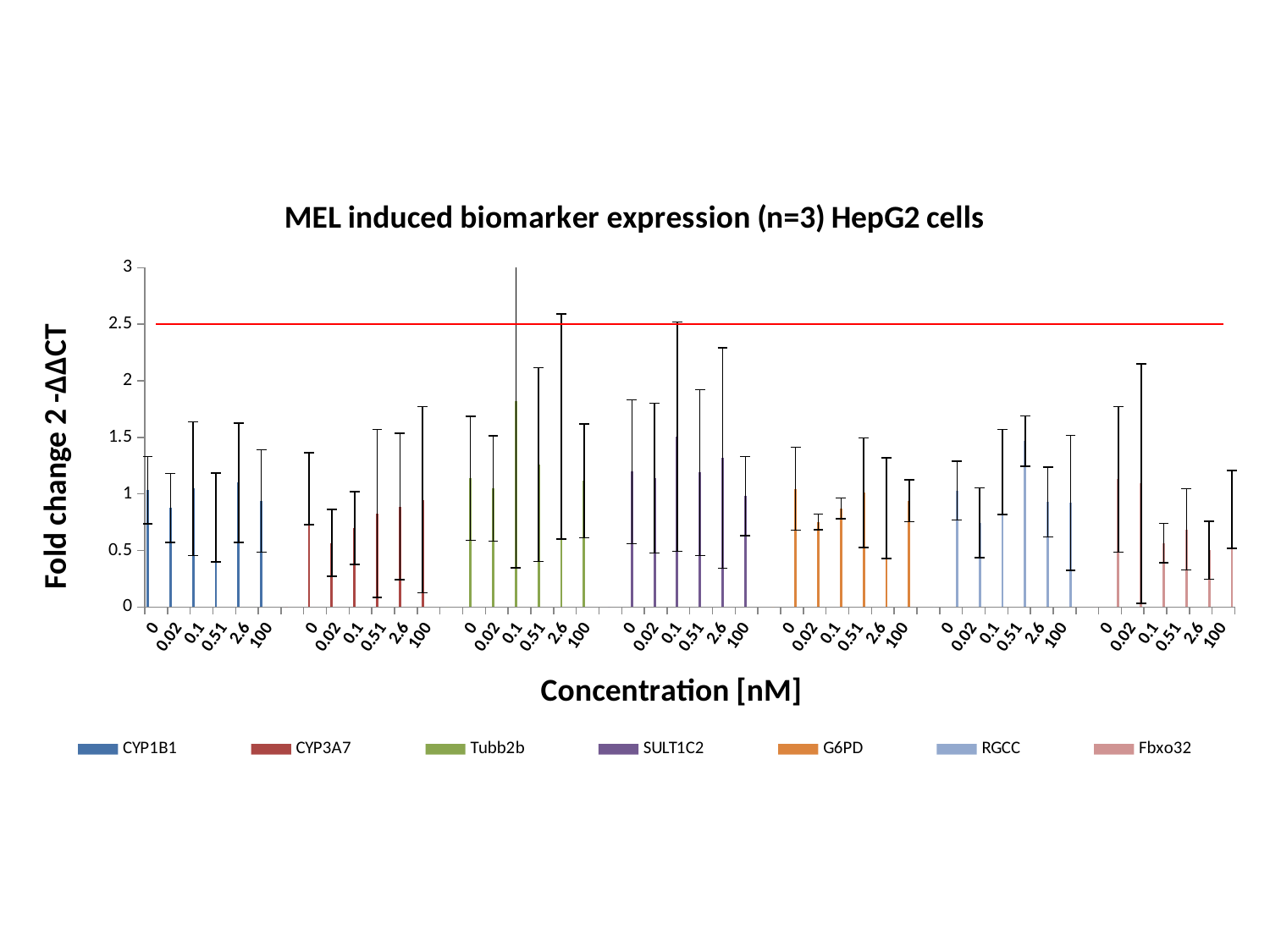
How many series does the legend list? 7 How many concentration categories are plotted for each biomarker? 6 Is the value for Tubb2b at 0.1 nM greater or less than 1.5? greater Is the value for G6PD at 0.02 nM greater or less than 1? less Is the value for SULT1C2 at 2.6 nM greater or less than 1? greater At which concentration does Tubb2b show its highest fold change? 0.1 What is the title of the chart? MEL induced biomarker expression (n=3) HepG2 cells What kind of chart is shown on the slide? bar chart Which is larger: the value for Tubb2b at 0.1 nM or the value for CYP1B1 at 0 nM? Tubb2b at 0.1 nM At what y-axis value is the horizontal red line drawn? 2.5